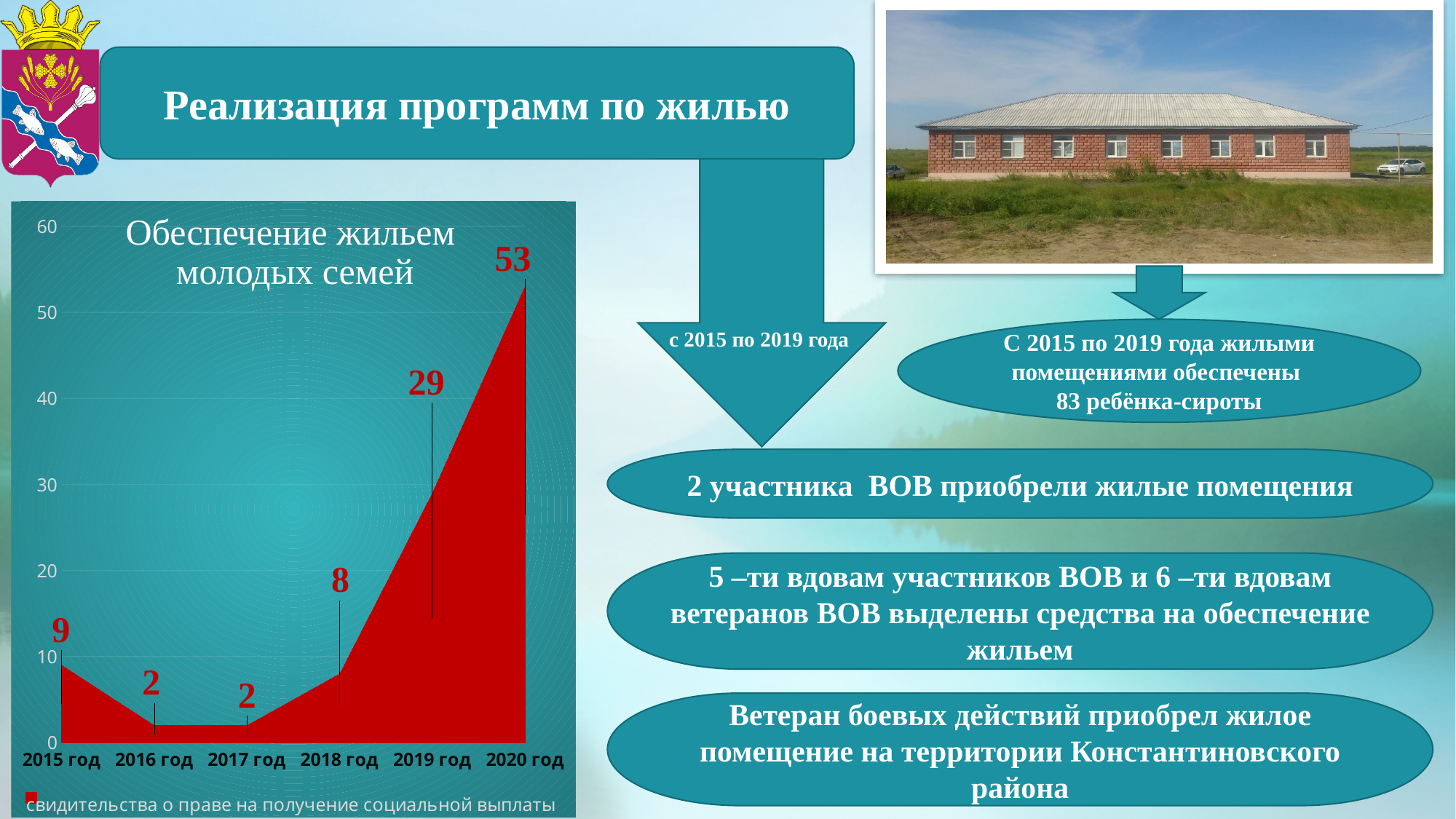
What is the difference between the values for 2020 год and 2019 год? 24 Do the values rise or fall from 2017 год to 2020 год? rise Which year has the highest value in the chart? 2020 год What is the value for 2019 год in the chart? 29 Which is larger, the value for 2015 год or the value for 2018 год? 2015 год How many years are shown on the x axis of the chart? 6 How many series does the chart legend list? 1 What is the value for 2018 год in the chart? 8 What is the title of the chart? Обеспечение жильем молодых семей What kind of chart is shown on the slide? area chart Is the value for 2020 год greater or less than 50? greater What is the value for 2015 год in the chart? 9